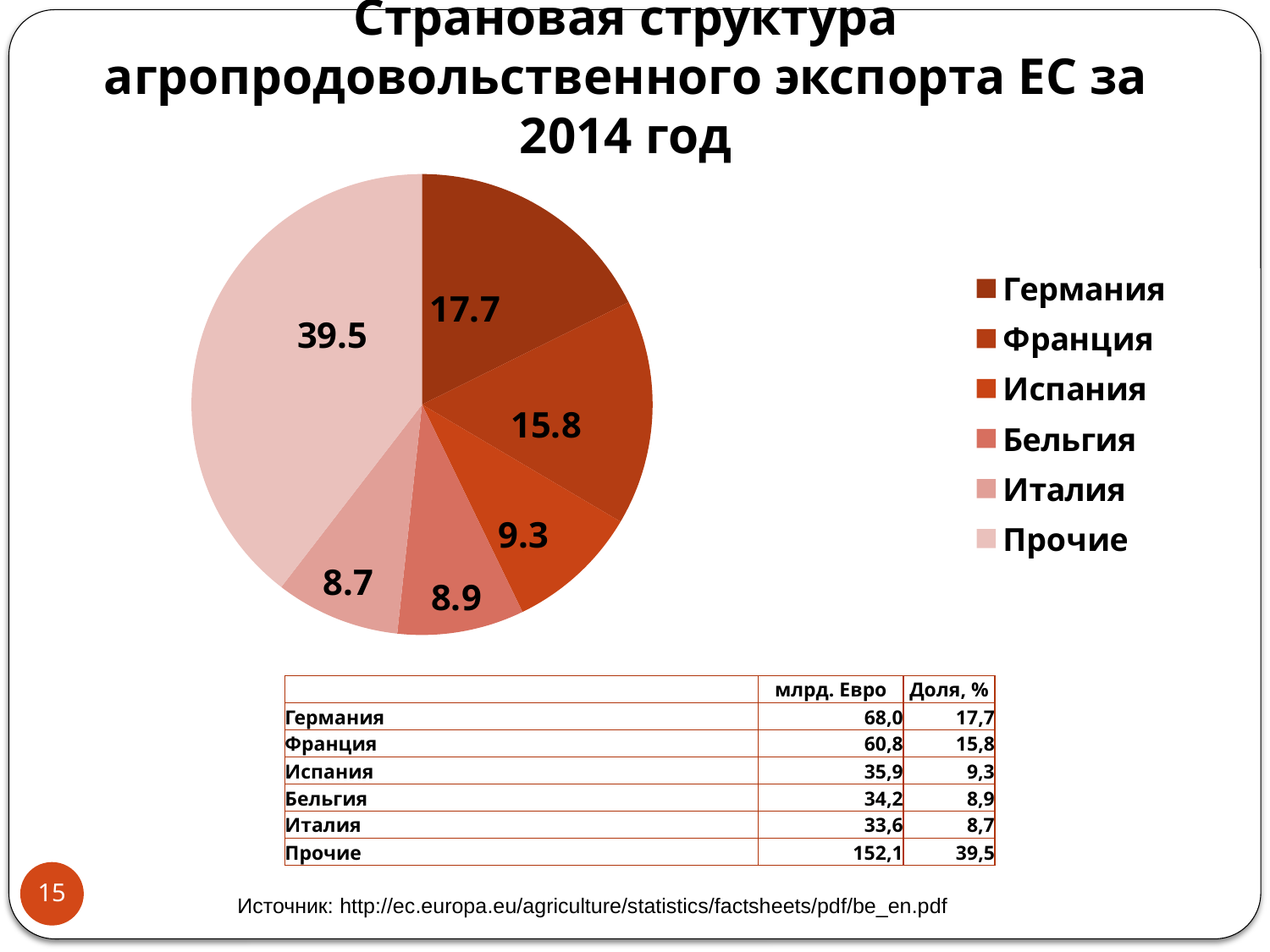
How many entries does the legend of the pie chart list? 6 What is the value shown for Германия in the pie chart? 17.7 What type of chart is shown on the slide? Pie chart How many slices does the pie chart have? 6 What is the value shown for Прочие in the pie chart? 39.5 What is the value shown for Франция in the pie chart? 15.8 What is the difference between the values for Германия and Франция in the pie chart? 1.9 What is the value shown for Испания in the pie chart? 9.3 Which category has the smallest slice in the pie chart? Италия Which category has the largest slice in the pie chart? Прочие What is the difference between the values for Прочие and Германия in the pie chart? 21.8 Which is larger in the pie chart, the value for Бельгия or the value for Испания? Испания